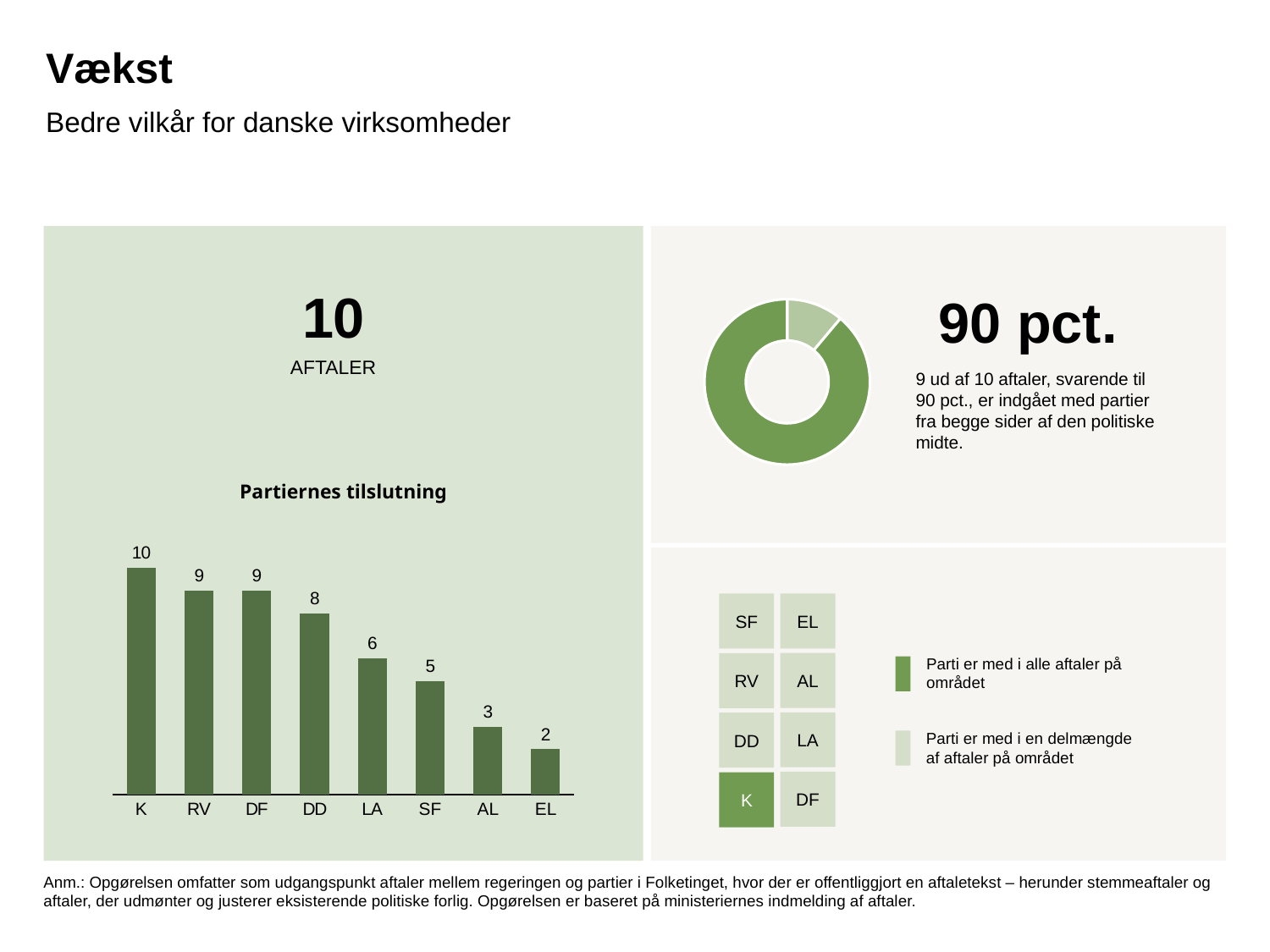
In the bar chart 'Partiernes tilslutning', what is the value for SF? 5 In the bar chart 'Partiernes tilslutning', which party has the lowest value? EL Do the values in the bar chart 'Partiernes tilslutning' rise or fall from left to right? Fall In the bar chart 'Partiernes tilslutning', what is the difference between the values for LA and AL? 3 In the bar chart 'Partiernes tilslutning', what is the value for K? 10 In the bar chart 'Partiernes tilslutning', what is the difference between the values for K and EL? 8 In the bar chart 'Partiernes tilslutning', which party has the highest value? K How many parties are shown in the bar chart 'Partiernes tilslutning'? 8 What kind of chart is 'Partiernes tilslutning'? Bar chart In the bar chart 'Partiernes tilslutning', what is the value for DD? 8 In the donut chart on the right, what share of the agreements is highlighted as made with parties from both sides of the political centre? 90 pct. In the bar chart 'Partiernes tilslutning', which is larger, the value for DD or the value for SF? DD